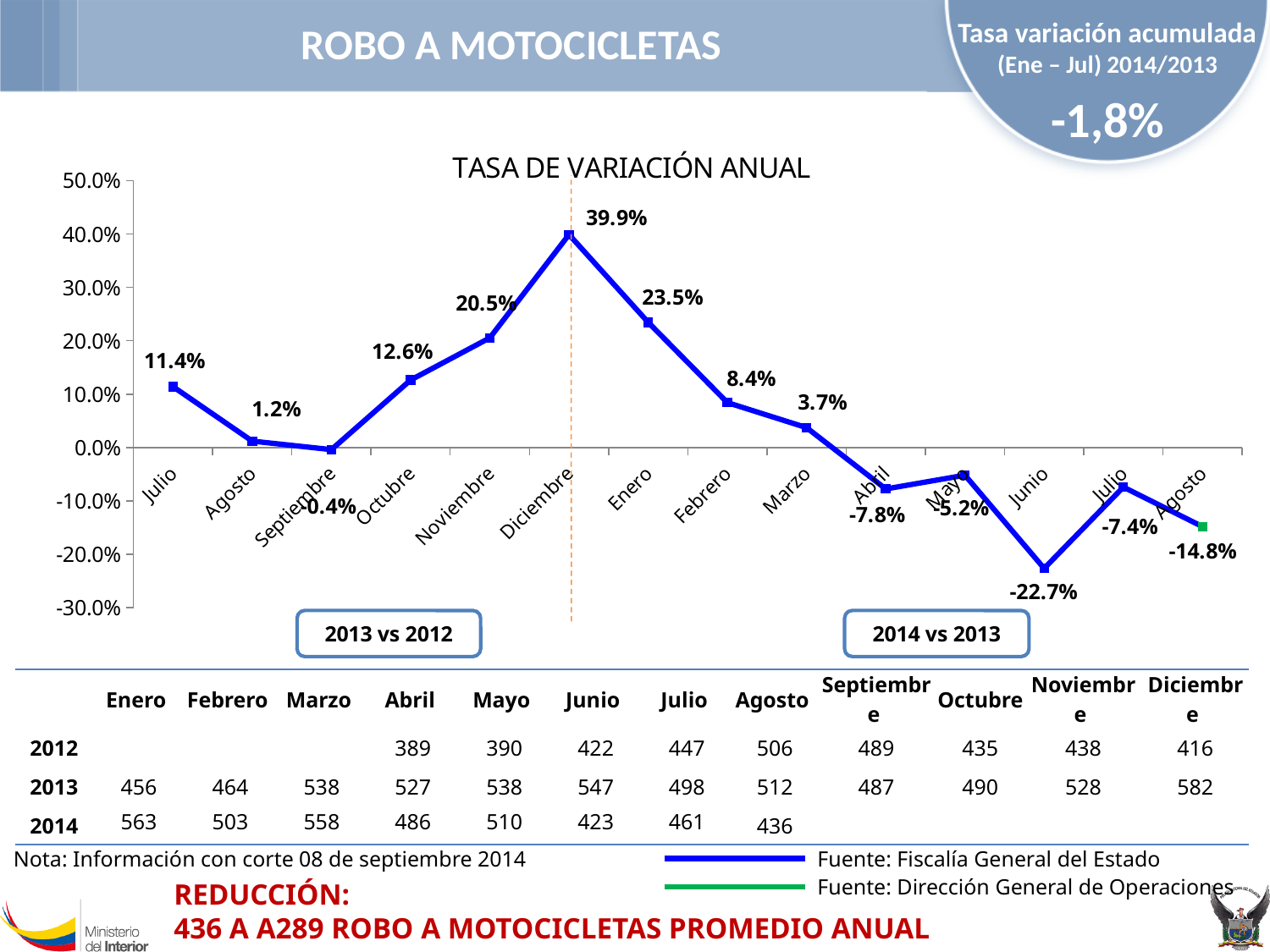
In the "TASA DE VARIACIÓN ANUAL" chart, what is the value for Diciembre? 39.9% In the "TASA DE VARIACIÓN ANUAL" chart, what is the value for Noviembre? 20.5% In the "TASA DE VARIACIÓN ANUAL" chart, do the values rise or fall from Diciembre to Marzo? Fall In the "TASA DE VARIACIÓN ANUAL" chart, which month has the lowest value? Junio What is the title of the line chart on the slide? TASA DE VARIACIÓN ANUAL In the "TASA DE VARIACIÓN ANUAL" chart, which month has the highest value? Diciembre In the "TASA DE VARIACIÓN ANUAL" chart, what is the value for Marzo? 3.7% What type of chart is shown under the title "TASA DE VARIACIÓN ANUAL"? Line chart How many data points are plotted in the "TASA DE VARIACIÓN ANUAL" chart? 14 In the "TASA DE VARIACIÓN ANUAL" chart, which is larger, the value for Octubre or the value for Febrero? Octubre In the "TASA DE VARIACIÓN ANUAL" chart, what is the difference between the values for Diciembre and Enero? 16.4% In the "TASA DE VARIACIÓN ANUAL" chart, what is the value for Junio? -22.7%